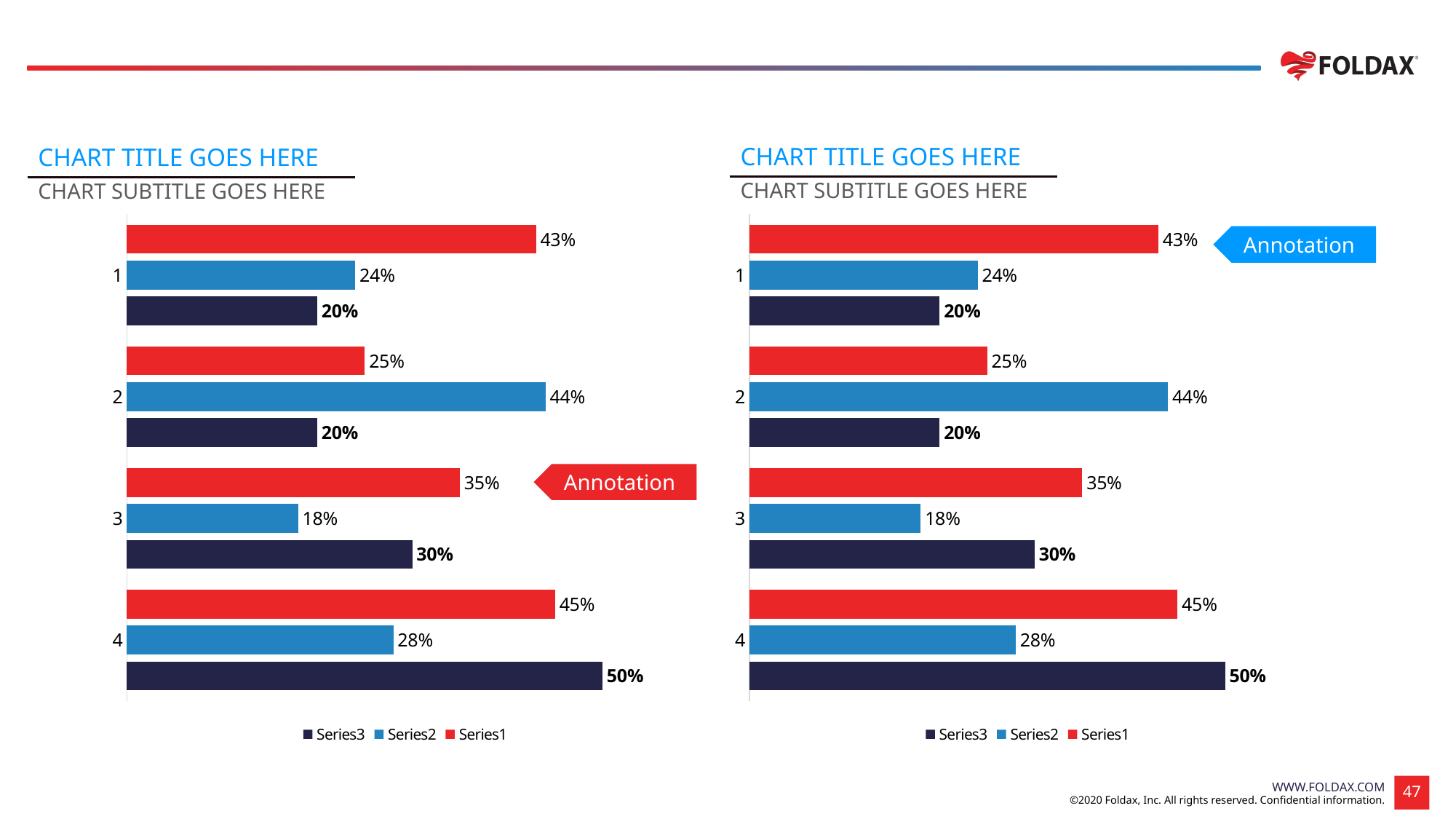
In the right chart, what is the difference between the Series1 value for category 4 and the Series1 value for category 2? 20% In the right chart, which category has the highest Series3 value? 4 How many categories are shown in the right chart? 4 In the right chart, what is the difference between the Series3 value for category 3 and the Series3 value for category 1? 10% In the left chart, which category has the lowest Series2 value? 3 What type of chart is the left chart? Bar chart In the left chart, which series is shown in red? Series1 How many series does the legend of the left chart list? 3 In the left chart, for category 3, which is larger: Series1 or Series2? Series1 In the right chart, what is the value of Series2 for category 2? 44% In the left chart, what is the value of Series3 for category 4? 50% In the left chart, what is the value of Series1 for category 1? 43%